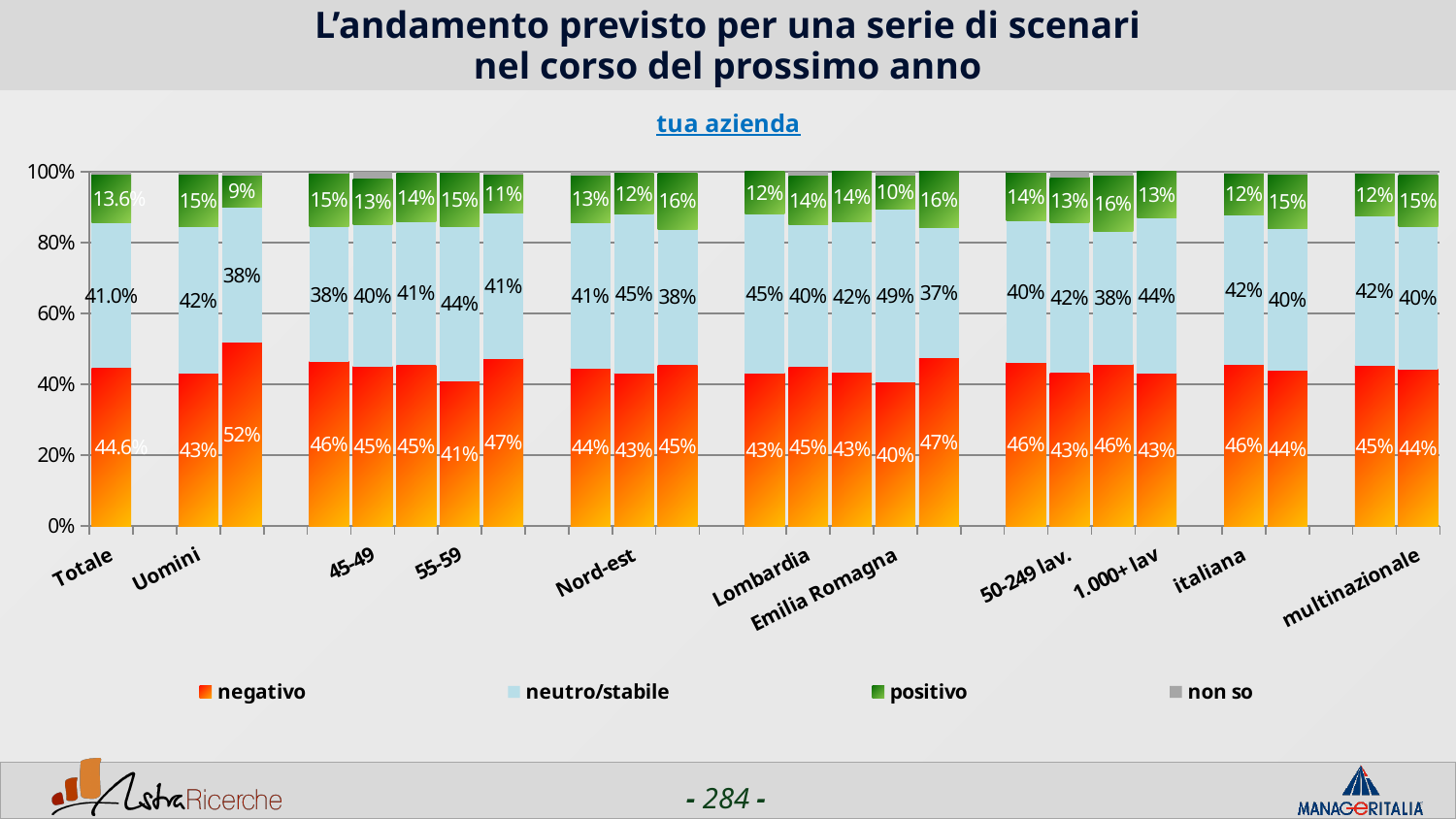
What is the 'positivo' value for 55-59? 15% What is the 'neutro/stabile' value for Emilia Romagna? 49% What is the 'positivo' value for Totale? 13.6% What is the first entry in the chart legend? negativo What is the 'negativo' value for Uomini? 43% How many series does the legend list? 4 What is the 'negativo' value for Totale? 44.6% What kind of chart is shown on the slide? Stacked bar chart What is the difference between the 'neutro/stabile' value (49%) and the 'negativo' value (40%) for Emilia Romagna? 9 percentage points What is the 'neutro/stabile' value for Totale? 41.0% Which is larger, the 'neutro/stabile' value for Emilia Romagna or for Lombardia? Emilia Romagna What is the 'negativo' value for 1.000+ lav? 43%